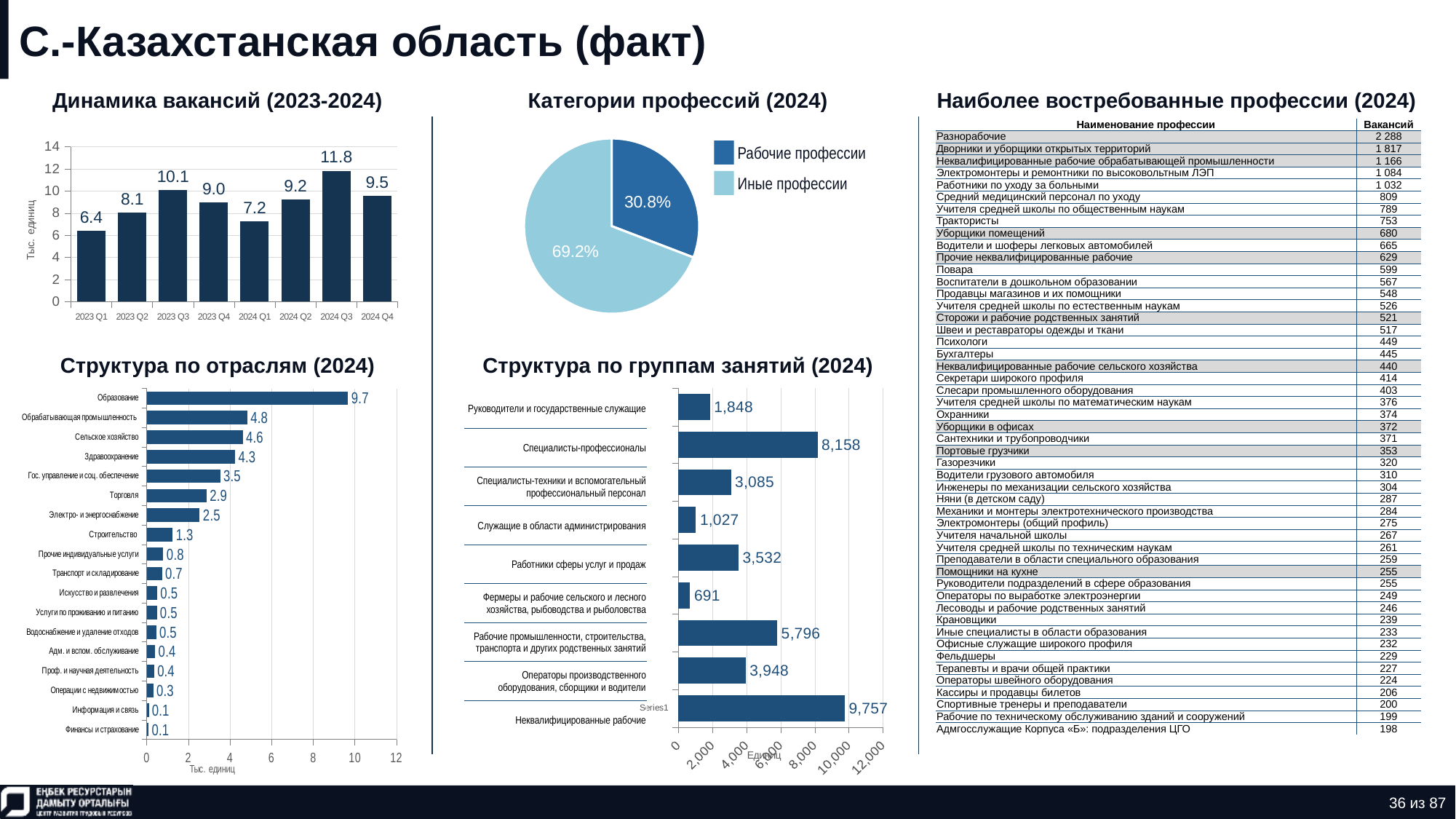
On the chart 'Структура по группам занятий (2024)', which group has the lowest value? Фермеры и рабочие сельского и лесного хозяйства, рыбоводства и рыболовства On the chart 'Структура по отраслям (2024)', which category has the highest value? Образование On the chart 'Динамика вакансий (2023-2024)', how many quarters are plotted? 8 On the chart 'Динамика вакансий (2023-2024)', what is the value for 2024 Q3? 11.8 On the chart 'Структура по отраслям (2024)', which is larger: 'Торговля' or 'Строительство'? Торговля What kind of chart is 'Категории профессий (2024)'? Pie chart On the chart 'Структура по группам занятий (2024)', what is the value for 'Специалисты-профессионалы'? 8,158 On the chart 'Категории профессий (2024)', what share of the pie is 'Рабочие профессии'? 30.8% On the chart 'Структура по группам занятий (2024)', how many occupation groups are plotted? 9 On the chart 'Структура по отраслям (2024)', what is the value for 'Здравоохранение'? 4.3 On the chart 'Динамика вакансий (2023-2024)', what is the difference between the values for 2024 Q3 and 2023 Q1? 5.4 On the chart 'Динамика вакансий (2023-2024)', which quarter has the lowest value? 2023 Q1